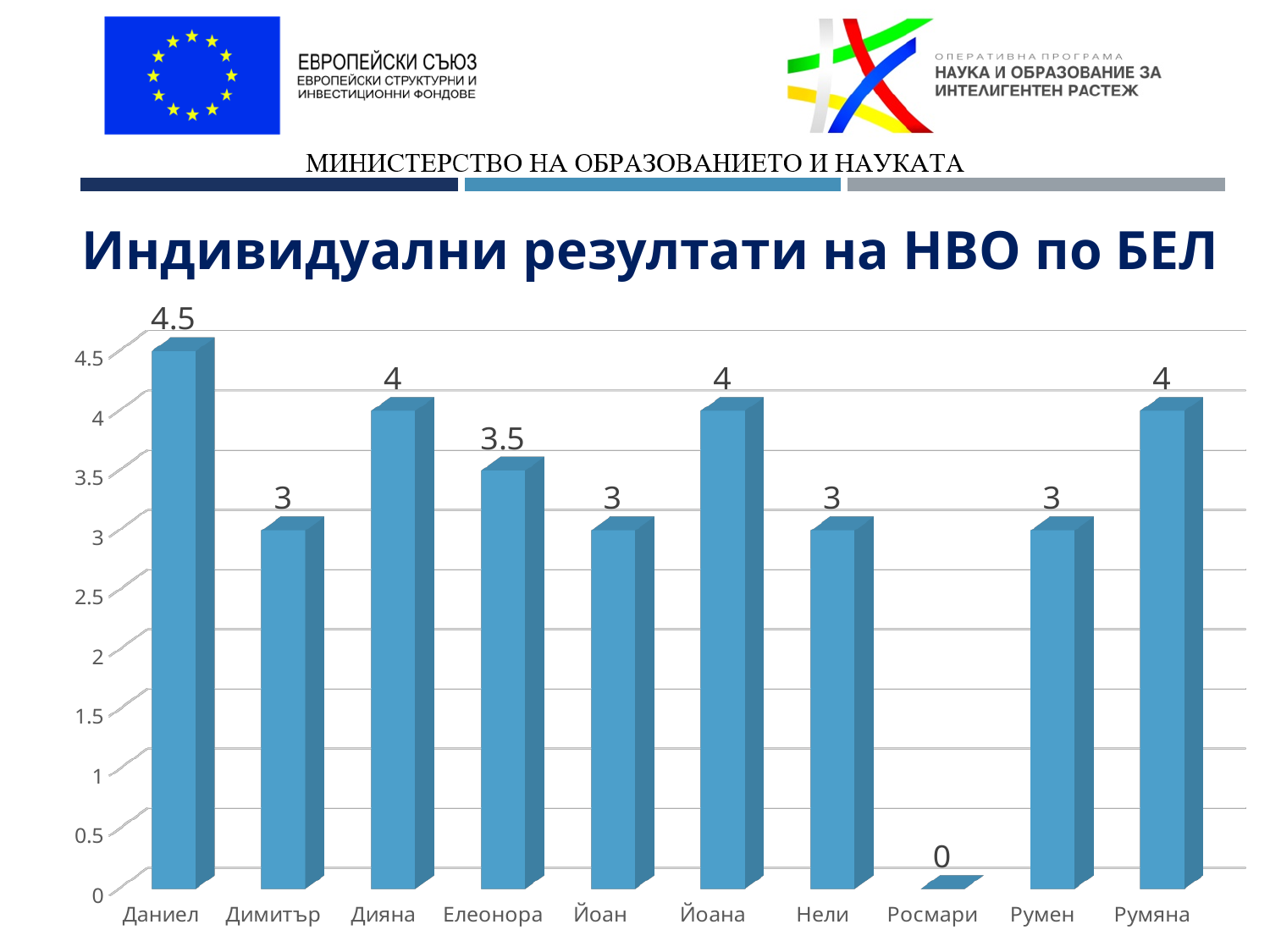
Is the value for Елеонора greater or less than 3? greater What is the title of the chart? Индивидуални резултати на НВО по БЕЛ How many categories are shown on the x axis? 10 Which is larger, the value for Дияна or the value for Йоан? Дияна What is the value for Румяна? 4 What is the value for Росмари? 0 Which category has the lowest value? Росмари What is the value for Даниел? 4.5 What kind of chart is shown on the slide? bar chart What is the difference between the values for Даниел and Димитър? 1.5 Which category has the highest value? Даниел What is the value for Елеонора? 3.5